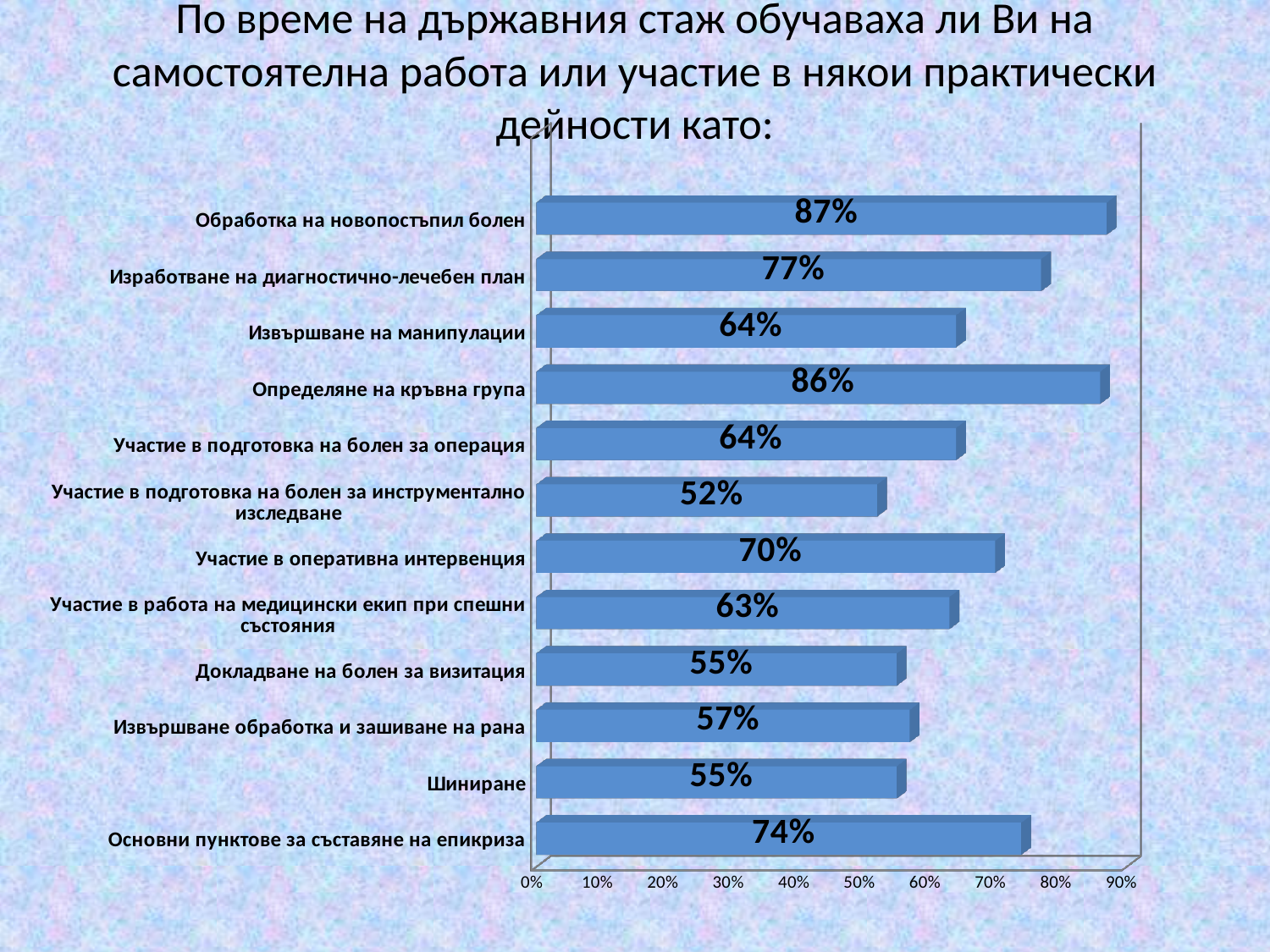
Which is larger: the value for "Определяне на кръвна група" or the value for "Участие в оперативна интервенция"? Определяне на кръвна група What is the value for "Участие в подготовка на болен за инструментално изследване"? 52% What is the value for "Обработка на новопостъпил болен"? 87% Is the value for "Извършване обработка и зашиване на рана" greater or less than 50%? greater What kind of chart is shown on the slide? bar chart What is the value for "Участие в оперативна интервенция"? 70% How many categories are shown in the chart? 12 Which category has the lowest value? Участие в подготовка на болен за инструментално изследване What is the difference between the values for "Обработка на новопостъпил болен" and "Шиниране"? 32% What is the difference between the values for "Изработване на диагностично-лечебен план" and "Извършване на манипулации"? 13% Which category has the highest value? Обработка на новопостъпил болен What is the value for "Основни пунктове за съставяне на епикриза"? 74%